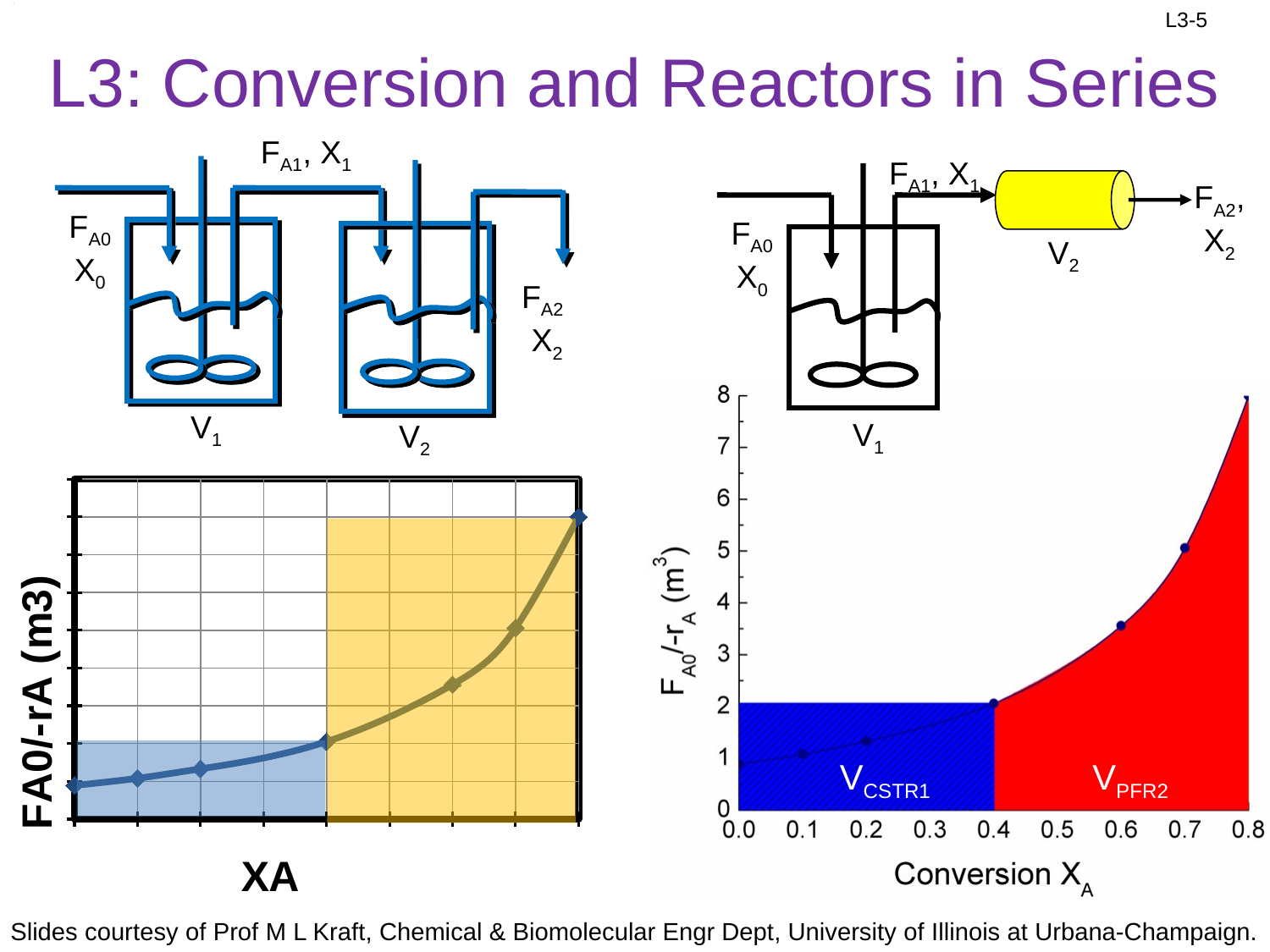
On the left chart (FA0/-rA vs XA), what is the label on the x axis? XA On the right chart, is the value of F_A0/-r_A at X_A = 0.1 greater or less than 2? less On the right chart, at which conversion X_A is the plotted value of F_A0/-r_A highest? 0.8 On the right chart, is the value of F_A0/-r_A at X_A = 0.7 greater or less than 6? less On the right chart, what label is shown in the blue shaded region? V_CSTR1 On the right chart, what is the value of F_A0/-r_A at a conversion X_A of 0.8? 8 On the left chart (FA0/-rA vs XA), do the values rise or fall as XA increases? rise On the right chart, do the values of F_A0/-r_A rise or fall as conversion X_A increases? rise On the right chart, which is larger: the value of F_A0/-r_A at X_A = 0.6 or at X_A = 0.4? X_A = 0.6 On the right chart (F_A0/-r_A vs Conversion X_A), what kind of chart is it? line chart On the right chart, is the value of F_A0/-r_A at X_A = 0.6 greater or less than 3? greater